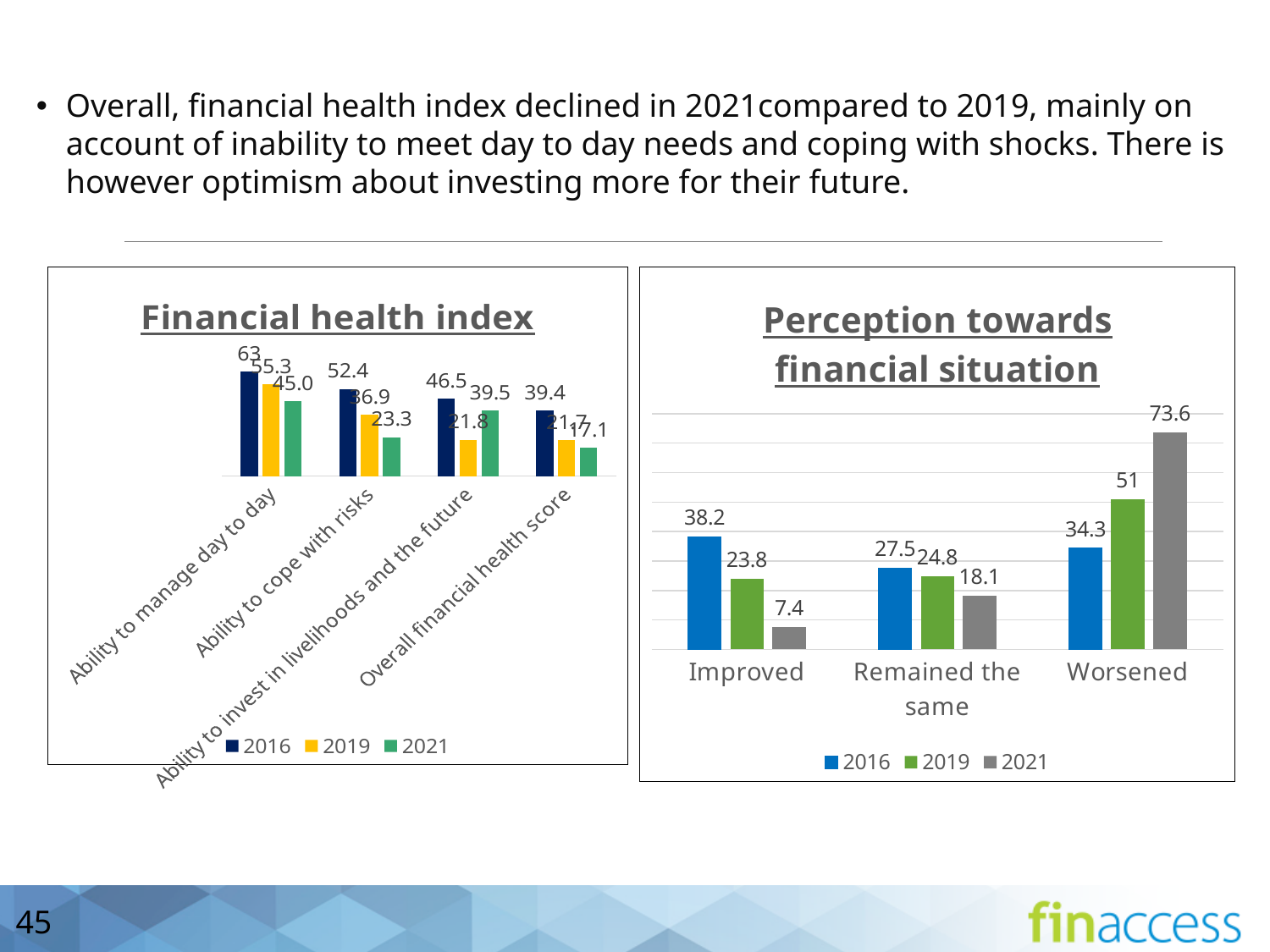
In the 'Financial health index' chart, how many categories are shown on the x axis? 4 In the 'Perception towards financial situation' chart, which category has the highest value for 2021? Worsened In the 'Perception towards financial situation' chart, what is the difference between the 2021 and 2016 values for Worsened? 39.3 In the 'Financial health index' chart, what is the value for 2021 for 'Ability to manage day to day'? 45.0 In the 'Perception towards financial situation' chart, what is the value for 2021 in the Worsened category? 73.6 In the 'Perception towards financial situation' chart, what is the value for 2021 in the Improved category? 7.4 In the 'Perception towards financial situation' chart, what is the value for 2019 in the Remained the same category? 24.8 In the 'Financial health index' chart, what is the value for 2016 for 'Ability to cope with risks'? 52.4 In the 'Financial health index' chart, what is the value for 2021 for 'Ability to invest in livelihoods and the future'? 39.5 In the 'Perception towards financial situation' chart, how many series does the legend list? 3 In the 'Perception towards financial situation' chart, what is the value for 2016 in the Improved category? 38.2 What kind of chart is the 'Financial health index' chart? Bar chart